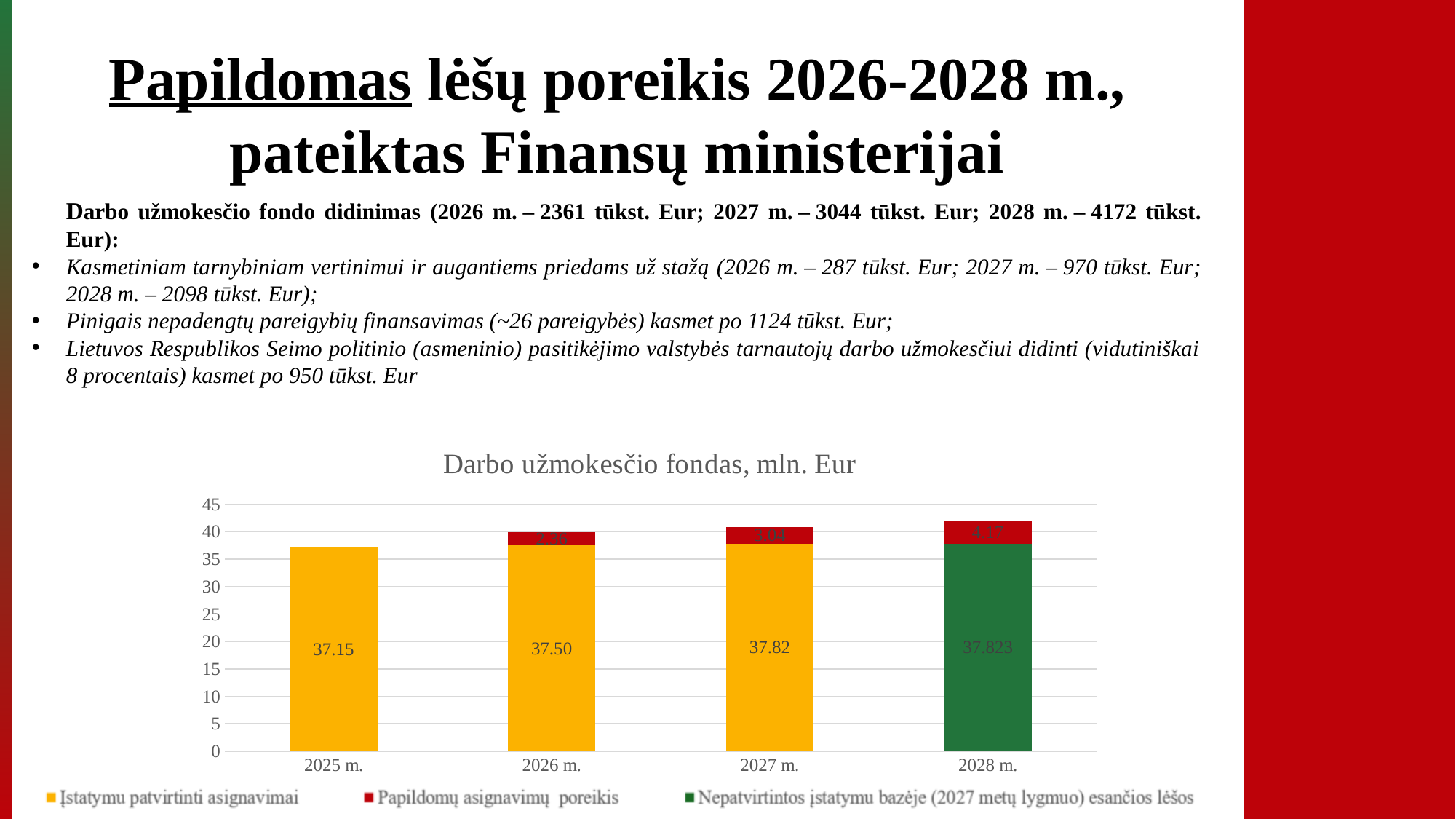
What is the value of 'Papildomų asignavimų poreikis' for 2027 m.? 3.04 What is the title of the chart? Darbo užmokesčio fondas, mln. Eur What is the value of the green series 'Nepatvirtintos įstatymu bazėje (2027 metų lygmuo) esančios lėšos' for 2028 m.? 37.823 What is the value of 'Papildomų asignavimų poreikis' for 2028 m.? 4.17 What type of chart is shown on the slide? Stacked bar chart What is the value of 'Įstatymu patvirtinti asignavimai' for 2026 m.? 37.50 What is the difference between the 'Papildomų asignavimų poreikis' values for 2028 m. and 2026 m.? 1.81 How many year categories are shown on the x axis of the chart? 4 What is the value of 'Įstatymu patvirtinti asignavimai' for 2025 m.? 37.15 How many series does the chart legend list? 3 Which year has the highest value for 'Papildomų asignavimų poreikis'? 2028 m. Does the 'Papildomų asignavimų poreikis' value rise or fall from 2026 m. to 2028 m.? Rise